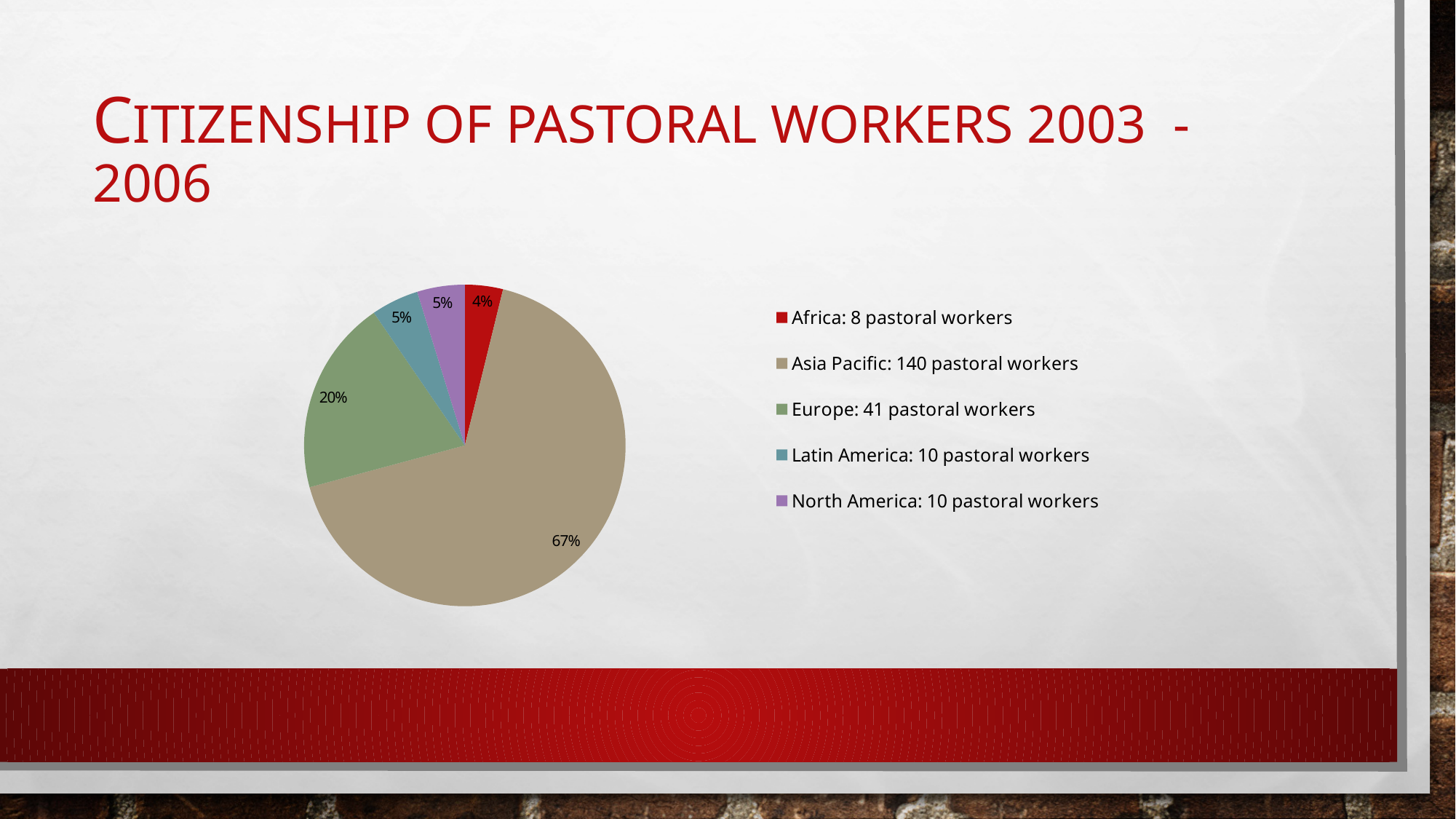
What kind of chart is shown on the slide? pie chart Which region has the smallest slice of the pie? Africa What percentage of the pie does Asia Pacific represent? 67% How many pastoral workers does the legend list for Europe? 41 pastoral workers How many pastoral workers does the legend list for Asia Pacific? 140 pastoral workers What percentage of the pie does Africa represent? 4% What percentage of the pie does Europe represent? 20% What is the difference in pastoral workers between Asia Pacific and Europe? 99 Which has more pastoral workers, Europe or Latin America? Europe How many pastoral workers does the legend list for Latin America? 10 pastoral workers How many regions are shown in the pie chart? 5 Which region has the largest slice of the pie? Asia Pacific